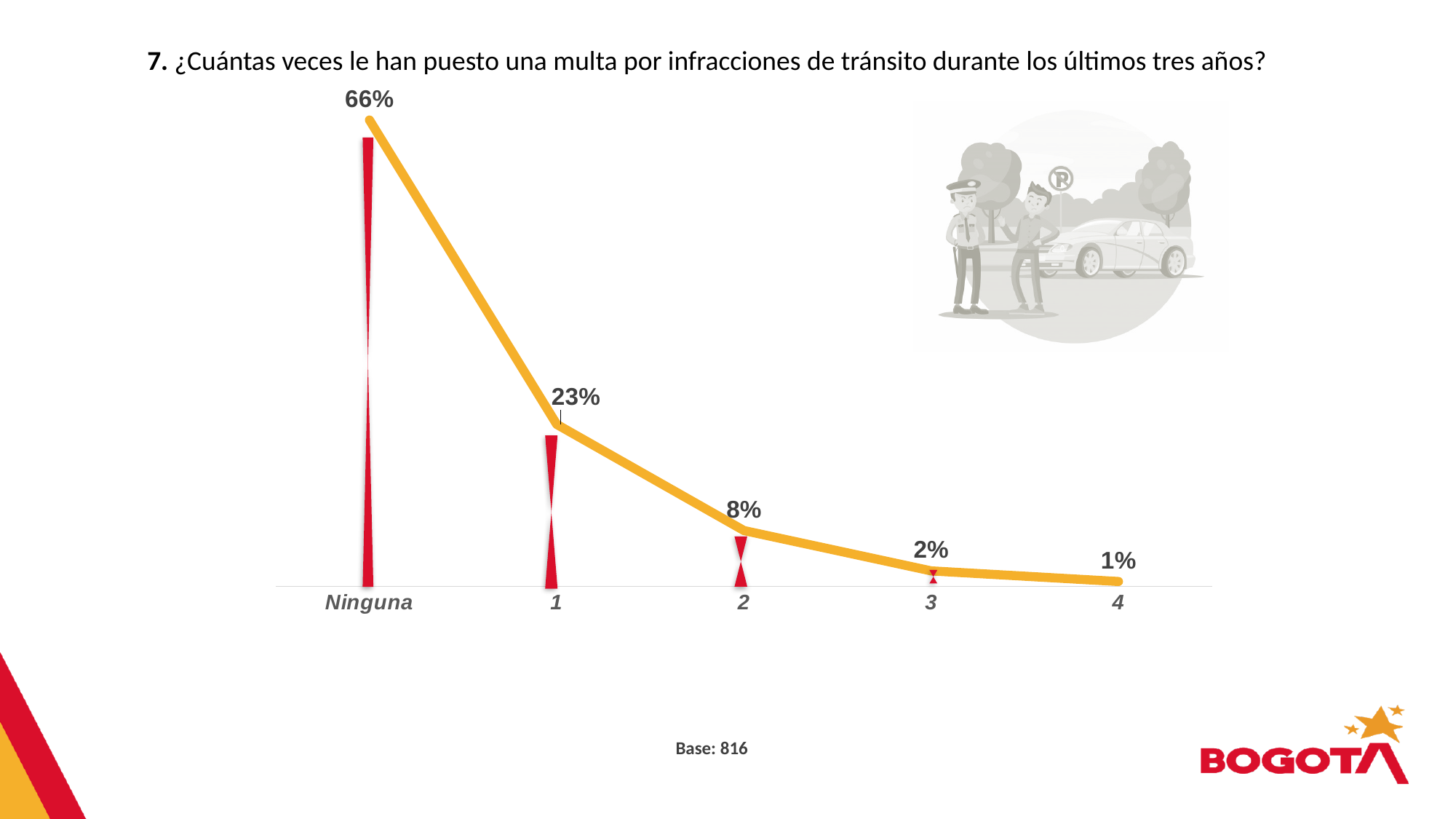
How many categories are shown on the x axis? 5 What is the value for Ninguna? 66% What is the value for category 3? 2% Which is larger, the value for 2 or the value for 3? 2 Do the values rise or fall from left to right along the x axis? fall What is the value for category 1? 23% Which category has the highest value? Ninguna What is the value for category 2? 8% What is the difference between the values for Ninguna and 1? 43% Which category has the lowest value? 4 What is the value for category 4? 1% What is the base (sample size) stated below the chart? 816